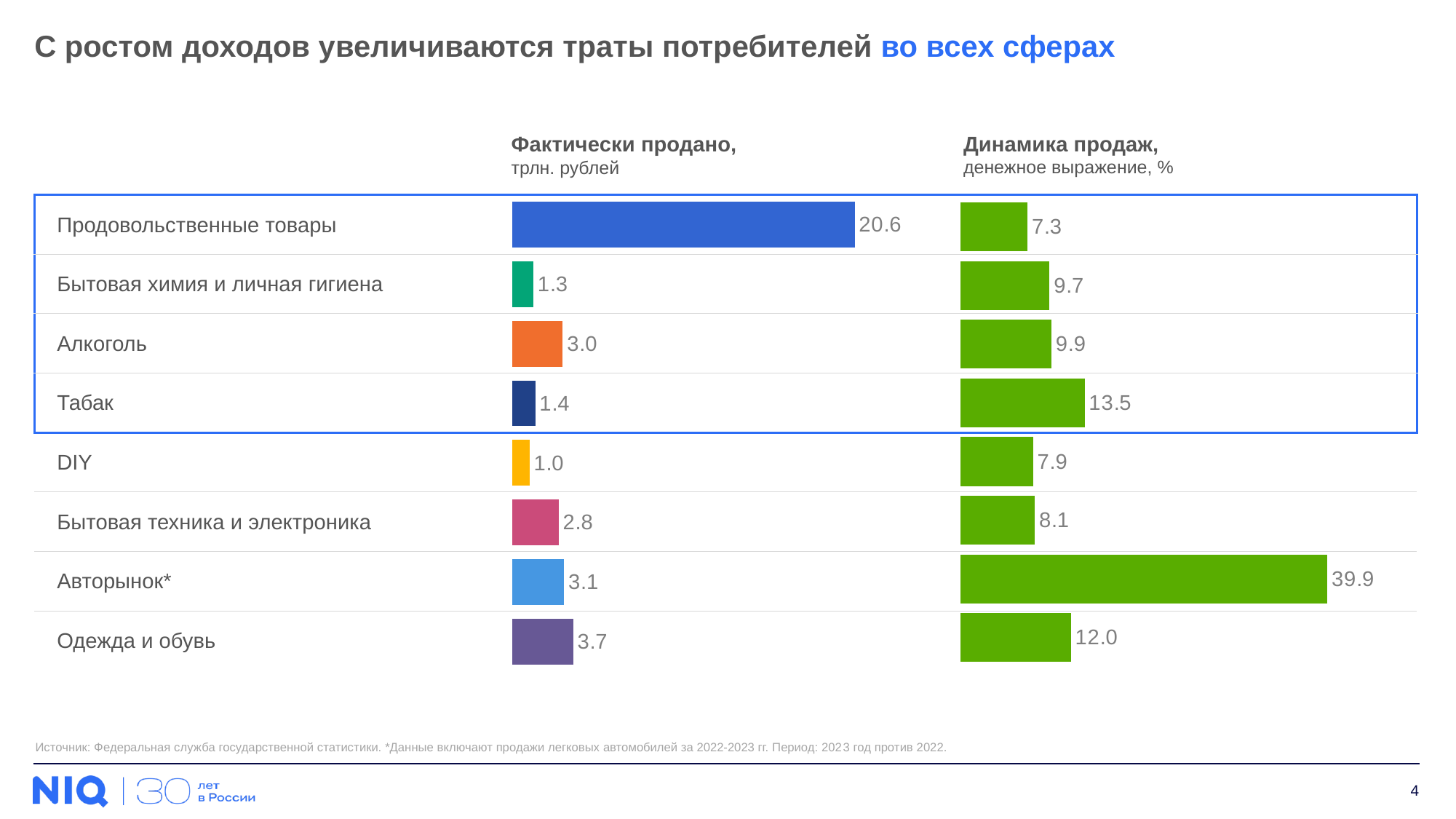
In the 'Динамика продаж, денежное выражение, %' chart, which category has the lowest value? Продовольственные товары In the 'Динамика продаж, денежное выражение, %' chart, what is the difference between Авторынок* and Одежда и обувь? 27.9 In the 'Динамика продаж, денежное выражение, %' chart, which category has the highest value? Авторынок* In the 'Фактически продано, трлн. рублей' chart, which category has the lowest value? DIY In the 'Динамика продаж, денежное выражение, %' chart, what is the value for Табак? 13.5 In the 'Фактически продано, трлн. рублей' chart, what is the difference between Одежда и обувь and Алкоголь? 0.7 How many categories are shown in the 'Фактически продано, трлн. рублей' chart? 8 What type of chart is the 'Динамика продаж, денежное выражение, %' chart? Bar chart In the 'Динамика продаж, денежное выражение, %' chart, what is the value for Авторынок*? 39.9 In the 'Фактически продано, трлн. рублей' chart, which is larger: Бытовая техника и электроника or Авторынок*? Авторынок* What colour are the bars in the 'Динамика продаж, денежное выражение, %' chart? Green In the 'Фактически продано, трлн. рублей' chart, what is the value for Продовольственные товары? 20.6